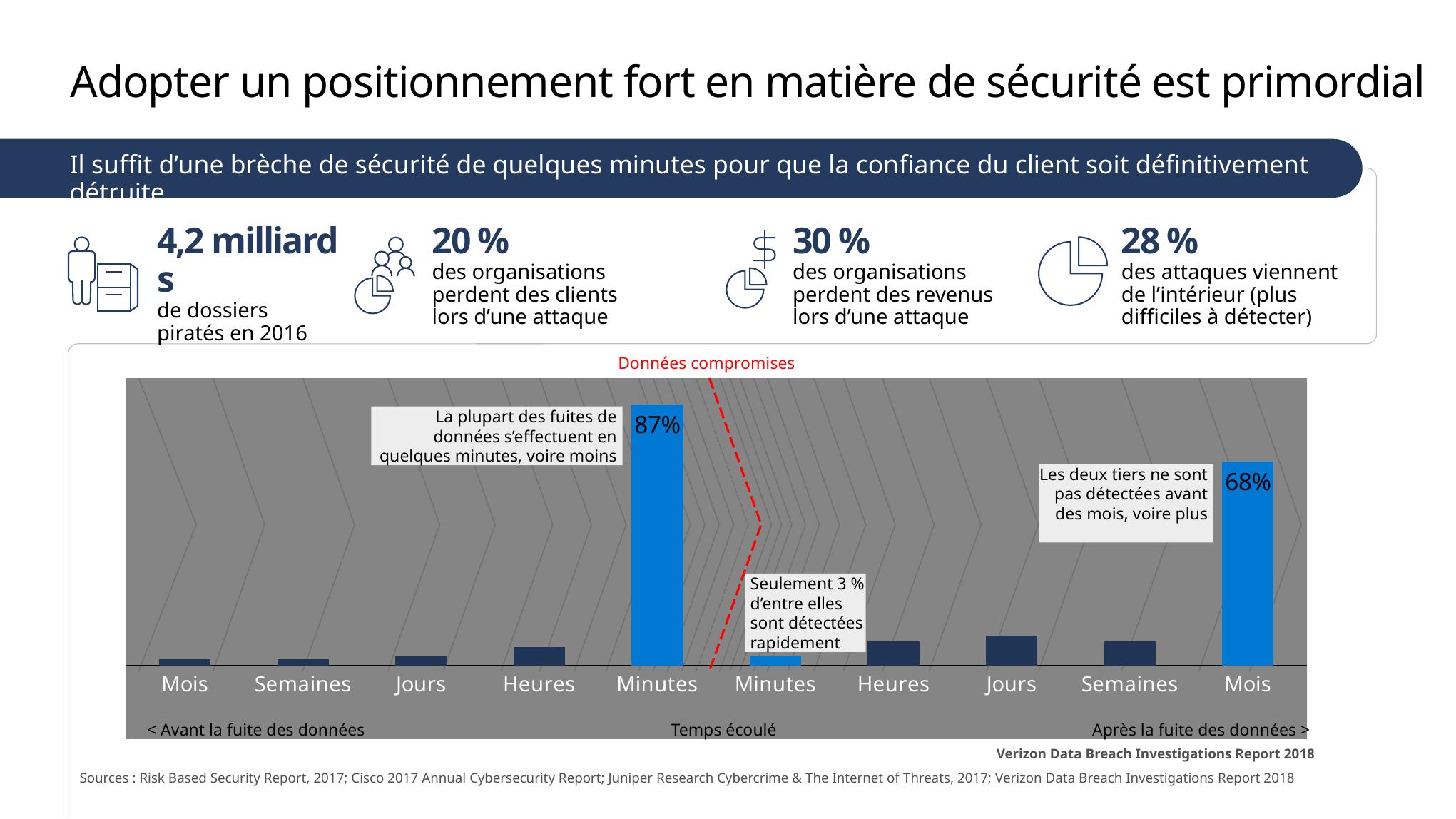
What is the difference between the 'Minutes' bar before the breach (87%) and the 'Mois' bar after the breach (68%)? 19 percentage points What is the value shown for the 'Minutes' bar before the data breach (left of the red dashed line)? 87% What type of chart is shown on the slide? Bar chart What label is written on the x axis of the chart? Temps écoulé In the section before the data breach, do the bars rise or fall from 'Mois' to 'Minutes'? Rise What is the value shown for the 'Mois' bar after the data breach (rightmost bar)? 68% Which is larger: the 'Minutes' bar before the breach or the 'Mois' bar after the breach? Minutes before the breach (87%) What does the red dashed line in the chart represent, according to its label? Données compromises Which bar in the chart is the highest? Minutes (before the data breach) Which is larger: the 'Heures' bar before the breach or the 'Minutes' bar before the breach? Minutes before the breach How many bars are plotted in the chart? 10